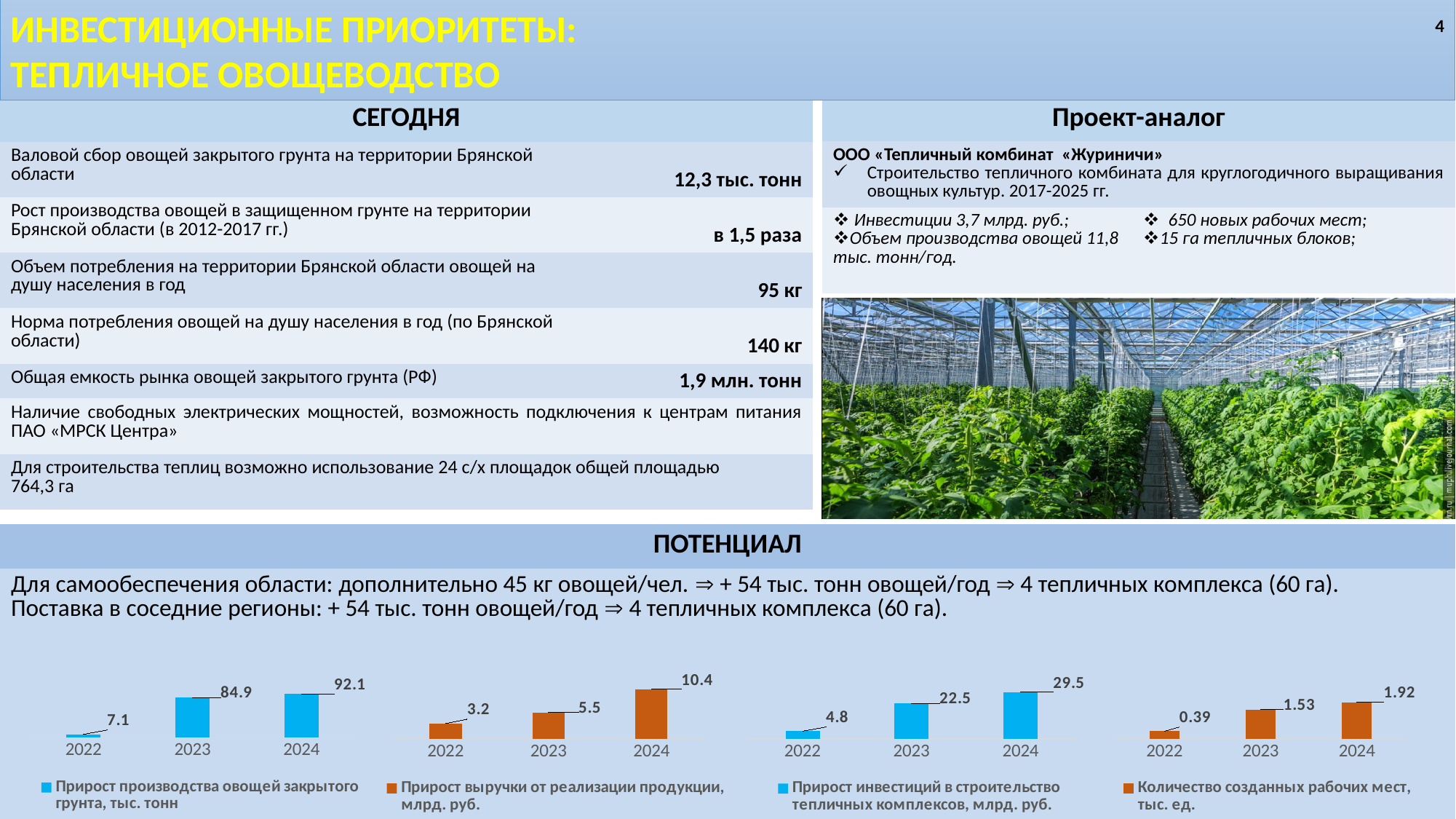
In the leftmost chart (Прирост производства овощей закрытого грунта, тыс. тонн), what is the value for 2023? 84.9 In the leftmost chart (Прирост производства овощей закрытого грунта, тыс. тонн), which year has the lowest value? 2022 In the rightmost chart (Количество созданных рабочих мест, тыс. ед.), what is the value for 2023? 1.53 How many years (categories) are shown in the rightmost chart (Количество созданных рабочих мест, тыс. ед.)? 3 In the third chart from the left (Прирост инвестиций в строительство тепличных комплексов, млрд. руб.), which year has the highest value? 2024 In the second chart from the left (Прирост выручки от реализации продукции, млрд. руб.), what is the value for 2024? 10.4 In the leftmost chart (Прирост производства овощей закрытого грунта, тыс. тонн), what is the difference between the 2024 and 2023 values? 7.2 In the rightmost chart (Количество созданных рабочих мест, тыс. ед.), which is larger, the value for 2022 or the value for 2024? 2024 In the second chart from the left (Прирост выручки от реализации продукции, млрд. руб.), what is the difference between the 2023 and 2022 values? 2.3 In the third chart from the left (Прирост инвестиций в строительство тепличных комплексов, млрд. руб.), what is the value for 2022? 4.8 What kind of chart is the leftmost chart (Прирост производства овощей закрытого грунта, тыс. тонн)? bar chart In the second chart from the left (Прирост выручки от реализации продукции, млрд. руб.), do the values rise or fall from 2022 to 2024? rise